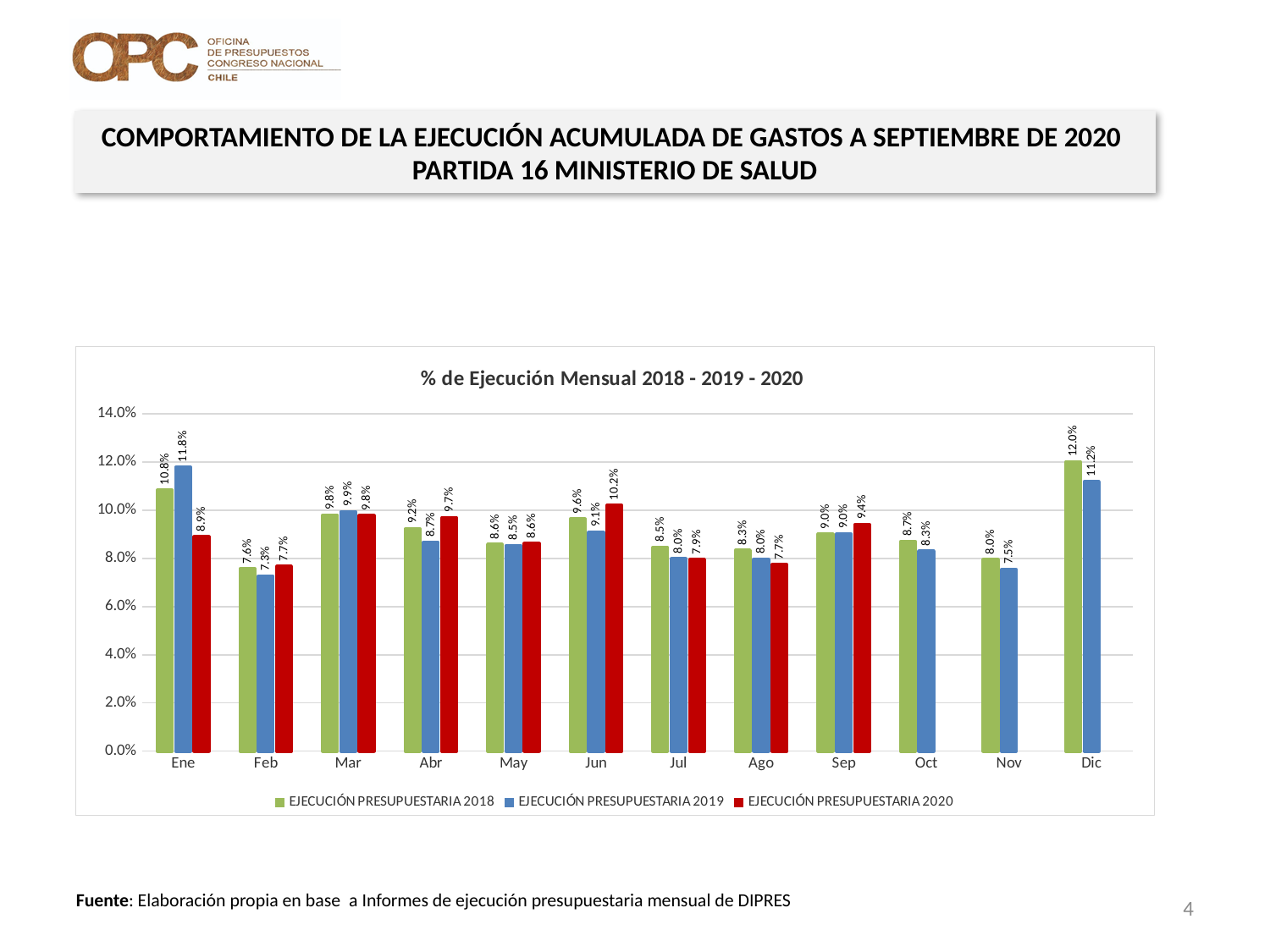
In Abr, which is larger: EJECUCIÓN PRESUPUESTARIA 2018 or EJECUCIÓN PRESUPUESTARIA 2020? EJECUCIÓN PRESUPUESTARIA 2020 What is the value for EJECUCIÓN PRESUPUESTARIA 2020 in Jun? 10.2% What is the value for EJECUCIÓN PRESUPUESTARIA 2019 in Nov? 7.5% In which month is EJECUCIÓN PRESUPUESTARIA 2019 lowest? Feb How many series does the legend list? 3 What is the title of the chart? % de Ejecución Mensual 2018 - 2019 - 2020 What is the difference between EJECUCIÓN PRESUPUESTARIA 2019 and EJECUCIÓN PRESUPUESTARIA 2020 in Ene? 2.9 percentage points In which month is EJECUCIÓN PRESUPUESTARIA 2020 highest? Jun How many months are shown on the x axis? 12 What is the value for EJECUCIÓN PRESUPUESTARIA 2019 in Ene? 11.8% What kind of chart is shown? Bar chart In which month is EJECUCIÓN PRESUPUESTARIA 2018 highest? Dic